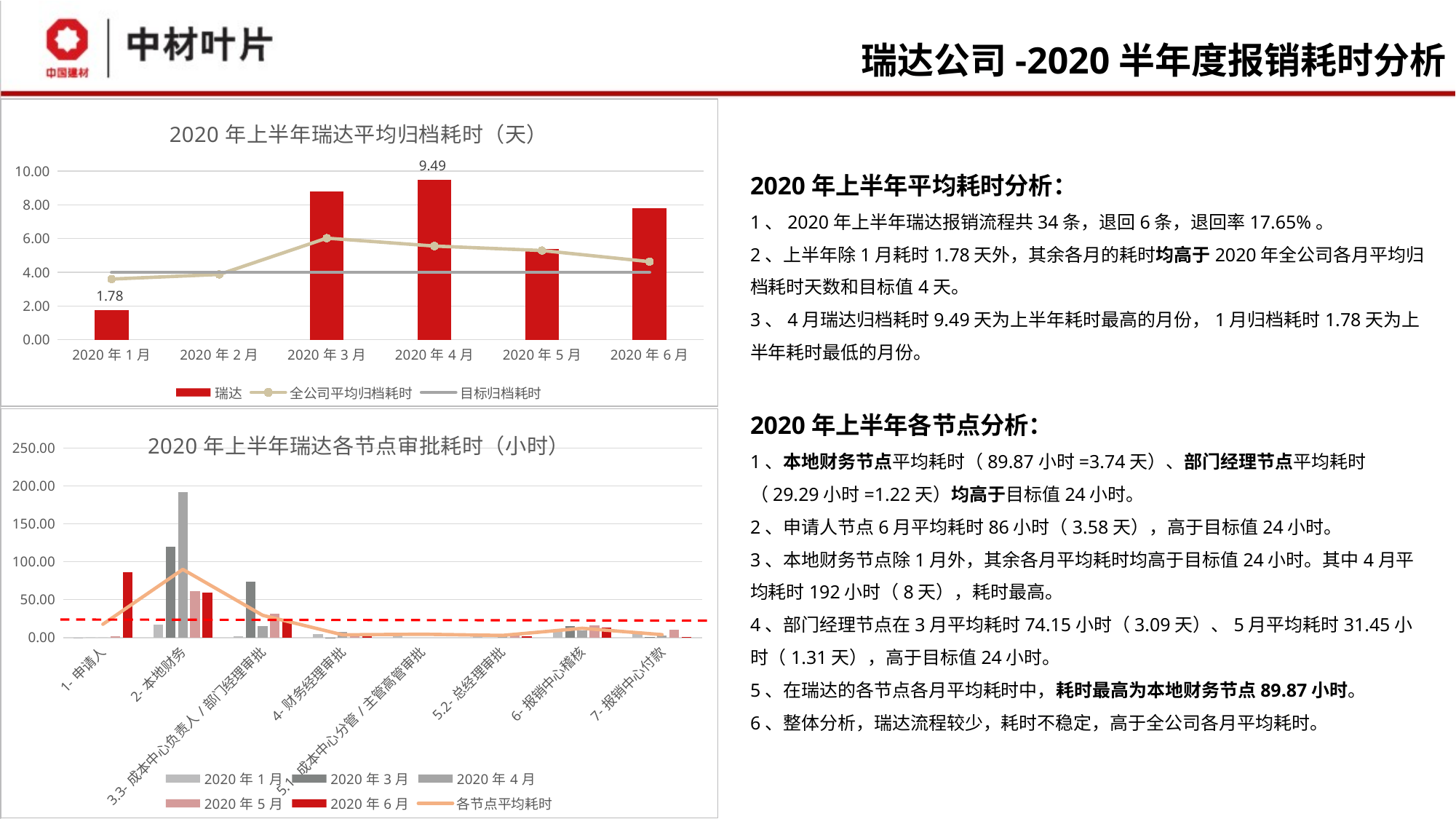
In the top chart (2020年上半年瑞达平均归档耗时), is the 瑞达 value for 2020年5月 greater or less than 4.00? greater In the top chart (2020年上半年瑞达平均归档耗时), which month has the highest 瑞达 bar? 2020年4月 In the top chart (2020年上半年瑞达平均归档耗时), what is the 瑞达 value for 2020年1月? 1.78 In the top chart (2020年上半年瑞达平均归档耗时), is the 瑞达 value for 2020年3月 greater or less than 8.00? greater How many months are shown on the x axis of the top chart (2020年上半年瑞达平均归档耗时)? 6 What kind of chart is the top chart titled 2020年上半年瑞达平均归档耗时（天）? combination bar and line chart How many approval nodes are shown on the x axis of the bottom chart (2020年上半年瑞达各节点审批耗时)? 8 In the bottom chart (2020年上半年瑞达各节点审批耗时), is the 2020年4月 value for 2-本地财务 greater or less than 150.00? greater How many series does the legend of the bottom chart (2020年上半年瑞达各节点审批耗时) list? 6 How many series does the legend of the top chart (2020年上半年瑞达平均归档耗时) list? 3 In the top chart (2020年上半年瑞达平均归档耗时), what is the 瑞达 value for 2020年4月? 9.49 In the top chart (2020年上半年瑞达平均归档耗时), what is the difference between the 瑞达 values for 2020年4月 and 2020年1月? 7.71